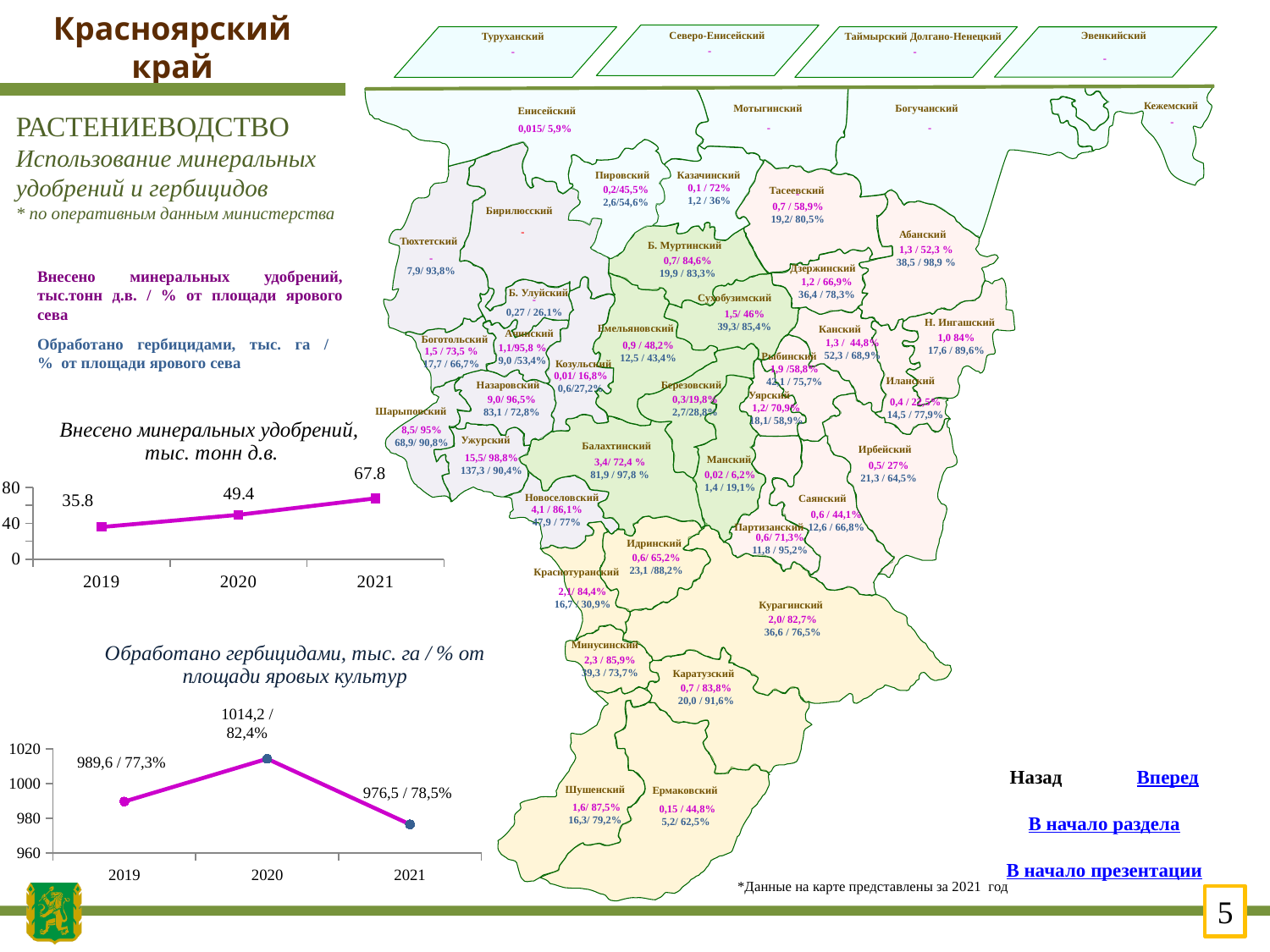
On the chart 'Внесено минеральных удобрений, тыс. тонн д.в.', do the values rise or fall from 2019 to 2021? rise On the chart 'Обработано гербицидами, тыс. га / % от площади яровых культур', what is the data label for 2020? 1014,2 / 82,4% On the chart 'Обработано гербицидами, тыс. га / % от площади яровых культур', is the value for 2019 greater or less than 1000? less On the chart 'Внесено минеральных удобрений, тыс. тонн д.в.', what is the difference between the 2021 and 2019 values? 32 What type of chart is 'Обработано гербицидами, тыс. га / % от площади яровых культур'? line chart On the chart 'Обработано гербицидами, тыс. га / % от площади яровых культур', what is the data label for 2021? 976,5 / 78,5% On the chart 'Внесено минеральных удобрений, тыс. тонн д.в.', which year has the highest value? 2021 On the chart 'Обработано гербицидами, тыс. га / % от площади яровых культур', which year has the lowest value in thousand hectares? 2021 On the chart 'Внесено минеральных удобрений, тыс. тонн д.в.', how many years are plotted? 3 On the chart 'Внесено минеральных удобрений, тыс. тонн д.в.', which year has the lowest value? 2019 On the chart 'Внесено минеральных удобрений, тыс. тонн д.в.', what is the value for 2019? 35.8 On the chart 'Внесено минеральных удобрений, тыс. тонн д.в.', what is the value for 2021? 67.8